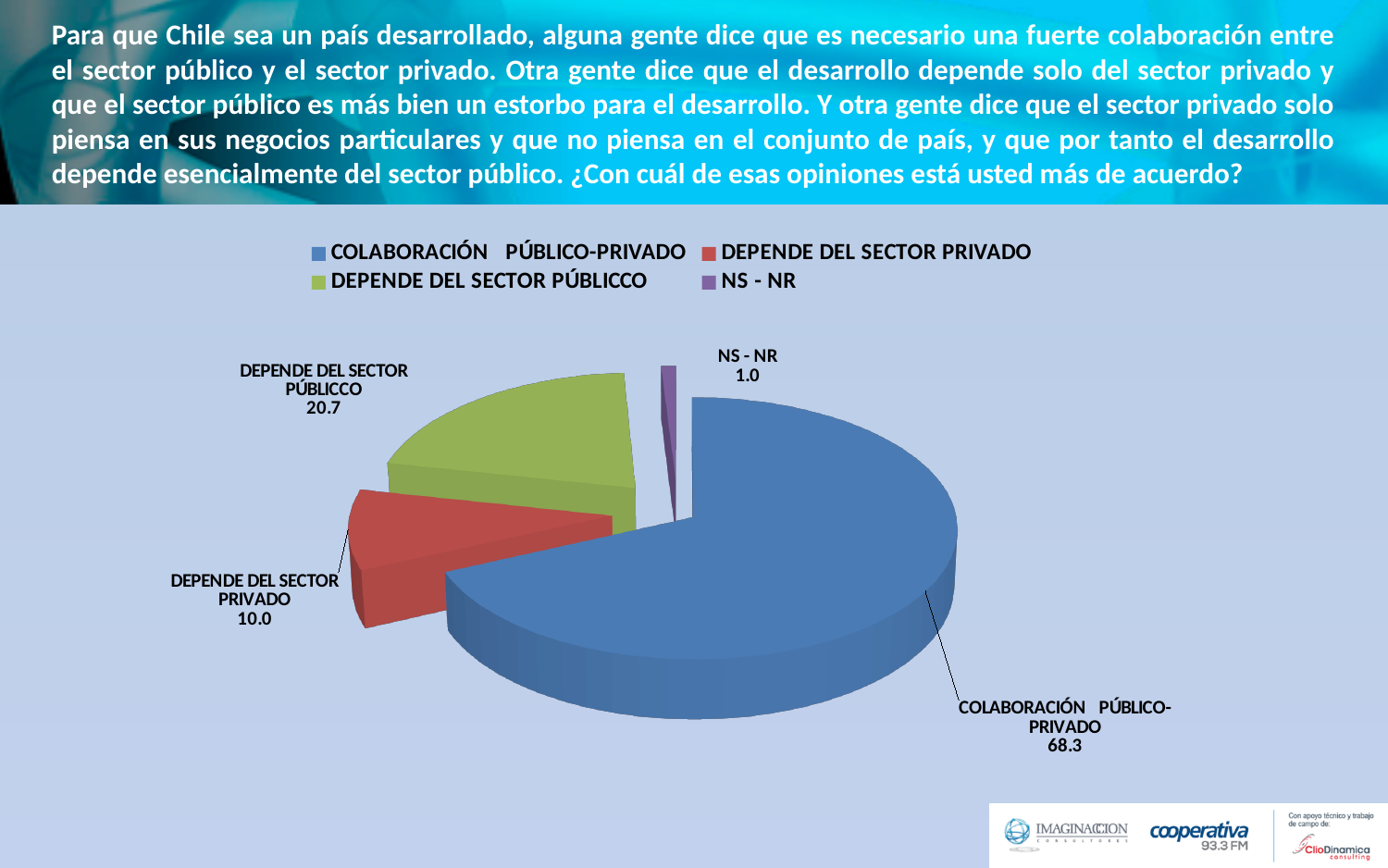
What is the value for DEPENDE DEL SECTOR PÚBLICCO? 20.7 What kind of chart is shown on the slide? Pie chart Which category has the smallest slice? NS - NR What is the value for DEPENDE DEL SECTOR PRIVADO? 10.0 What is the value for NS - NR? 1.0 What is the value for COLABORACIÓN PÚBLICO-PRIVADO? 68.3 How many slices does the pie chart have? 4 Which is larger, DEPENDE DEL SECTOR PRIVADO or DEPENDE DEL SECTOR PÚBLICCO? DEPENDE DEL SECTOR PÚBLICCO What colour is the slice for DEPENDE DEL SECTOR PRIVADO? Red What is the difference between the values for DEPENDE DEL SECTOR PÚBLICCO and DEPENDE DEL SECTOR PRIVADO? 10.7 Which category has the largest slice? COLABORACIÓN PÚBLICO-PRIVADO What is the difference between the values for COLABORACIÓN PÚBLICO-PRIVADO and DEPENDE DEL SECTOR PÚBLICCO? 47.6